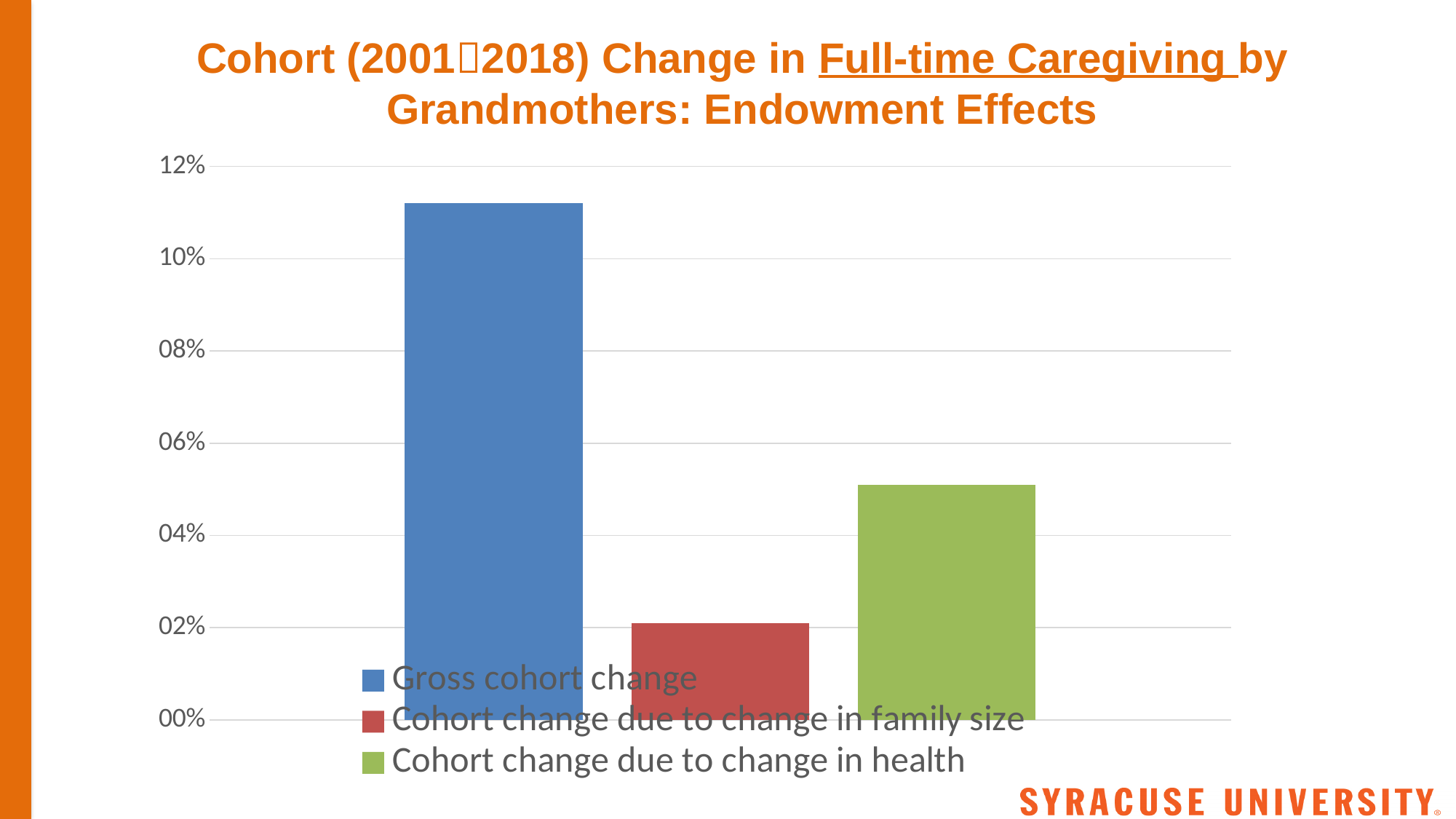
Is the value for Cohort change due to change in health greater or less than 6%? less Which is larger: the value for Gross cohort change or the value for Cohort change due to change in health? Gross cohort change How many series does the legend list? 3 Which is larger: the value for Cohort change due to change in health or the value for Cohort change due to change in family size? Cohort change due to change in health Is the value for Cohort change due to change in family size greater or less than 4%? less How many bars are plotted in the chart? 3 Which series has the highest value? Gross cohort change Is the value for Cohort change due to change in health greater or less than 4%? greater What kind of chart is shown on the slide? Bar chart Which series has the lowest value? Cohort change due to change in family size What colour is the bar for Cohort change due to change in health? Green